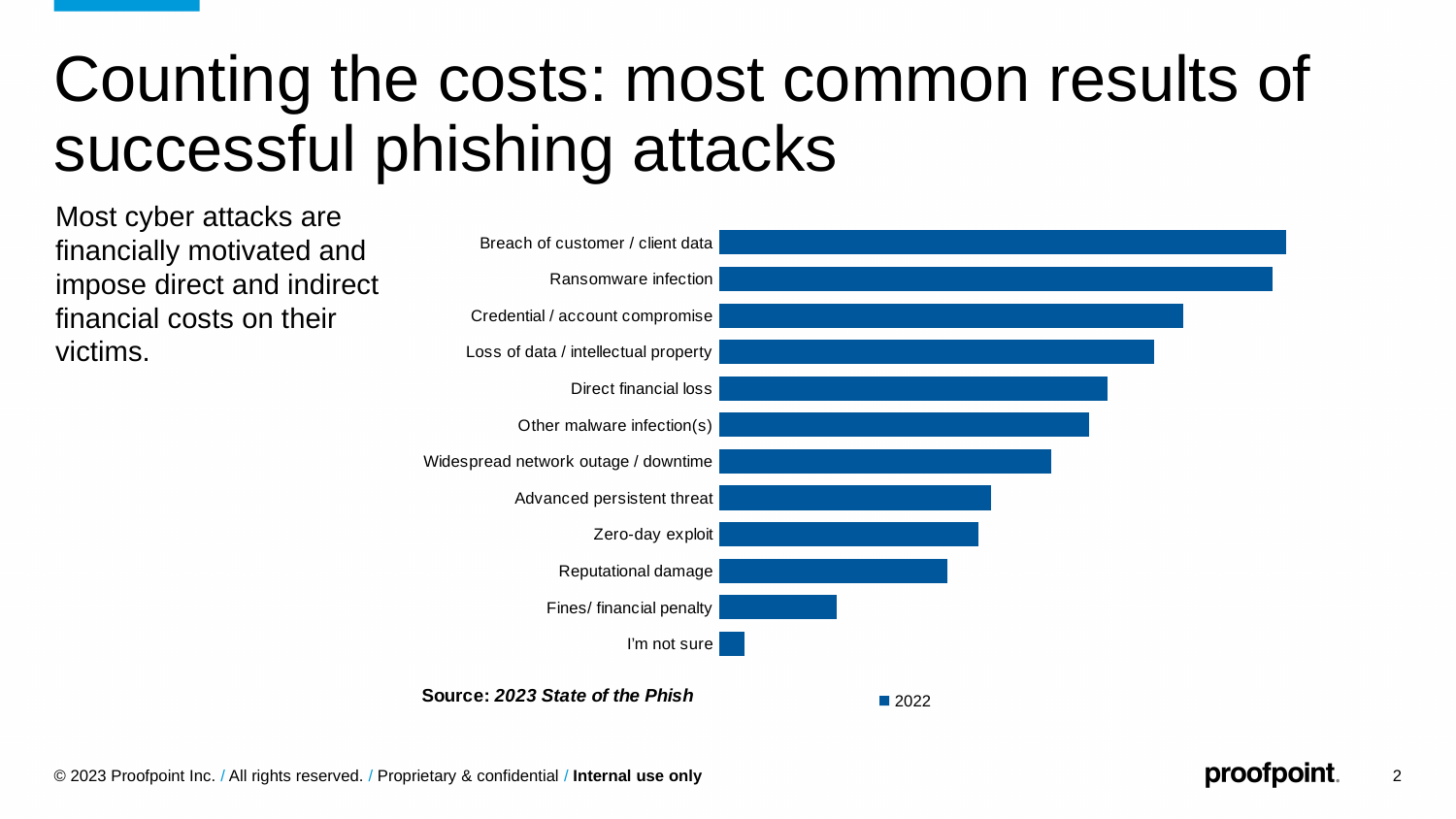
Which category has the shortest bar in the chart? I'm not sure What year does the chart legend show? 2022 Which category has the longest bar in the chart? Breach of customer / client data Which has the larger value: Other malware infection(s) or Widespread network outage / downtime? Other malware infection(s) Which category is second from the top in the chart? Ransomware infection How many series does the chart legend list? 1 What kind of chart is shown on the slide? Bar chart How many categories are plotted in the chart? 12 Which has the larger value: Reputational damage or Fines/ financial penalty? Reputational damage Which has the larger value: Advanced persistent threat or Fines/ financial penalty? Advanced persistent threat